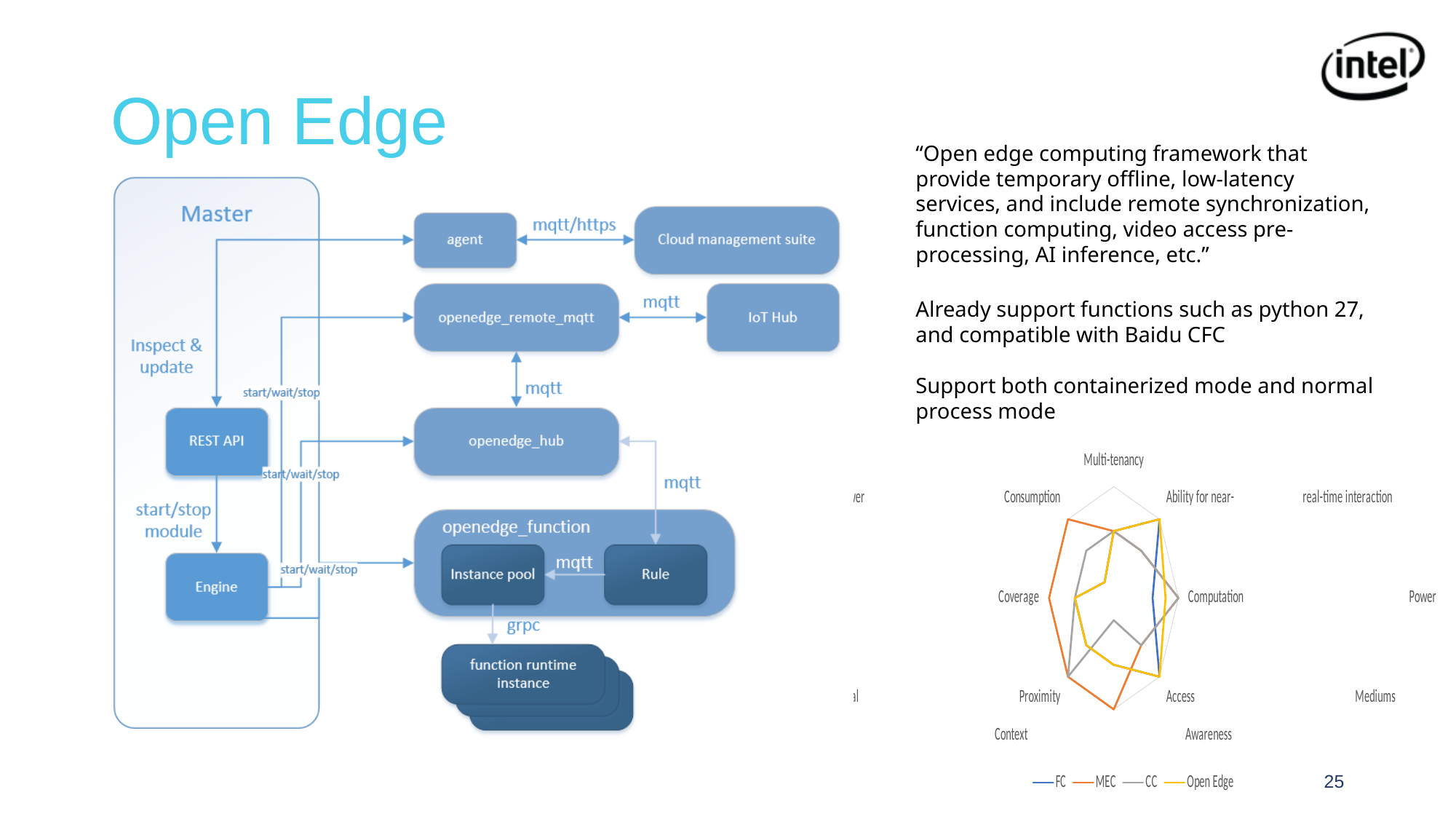
What colour is the Open Edge series in the radar chart? yellow In the radar chart, which series extends furthest along the Proximity axis? MEC and CC (tied) What are the series names listed in the legend of the radar chart? FC, MEC, CC, Open Edge In the radar chart, which series extends further along the Coverage axis, MEC or Open Edge? MEC What kind of chart is shown on the right side of the slide? radar chart In the radar chart, which series extends furthest along the Coverage axis? MEC How many series does the legend of the radar chart list? 4